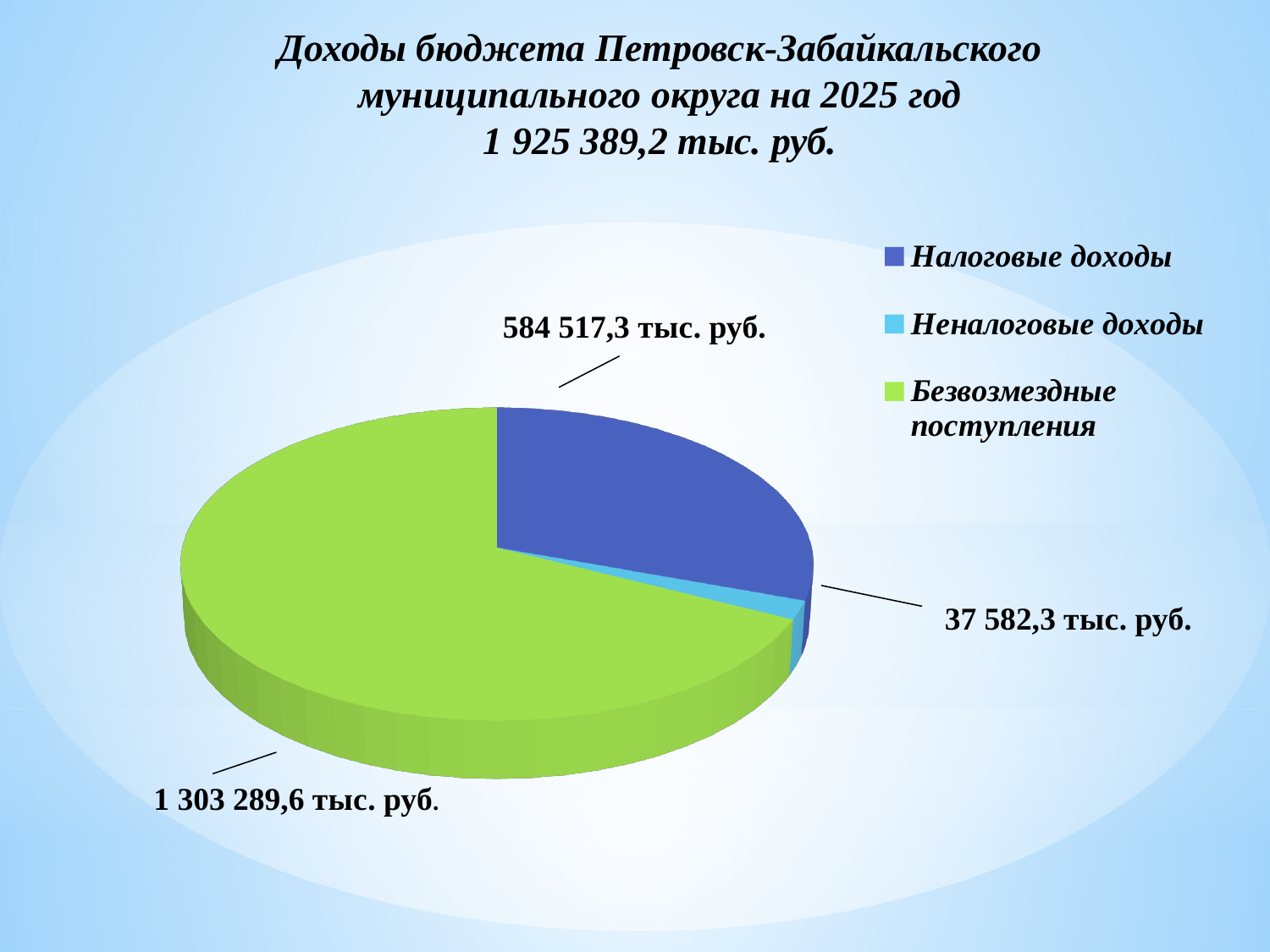
How many slices does the pie chart have? 3 How many entries does the legend list? 3 What is the difference between Налоговые доходы and Неналоговые доходы? 546 935,0 тыс. руб. Which category has the largest slice of the pie? Безвозмездные поступления What is the value for Неналоговые доходы? 37 582,3 тыс. руб. What is the value for Безвозмездные поступления? 1 303 289,6 тыс. руб. What is the value for Налоговые доходы? 584 517,3 тыс. руб. What is the difference between Безвозмездные поступления and Налоговые доходы? 718 772,3 тыс. руб. What colour is the slice for Безвозмездные поступления? Green Which is larger, Налоговые доходы or Неналоговые доходы? Налоговые доходы What kind of chart is shown on the slide? Pie chart Which category has the smallest slice of the pie? Неналоговые доходы